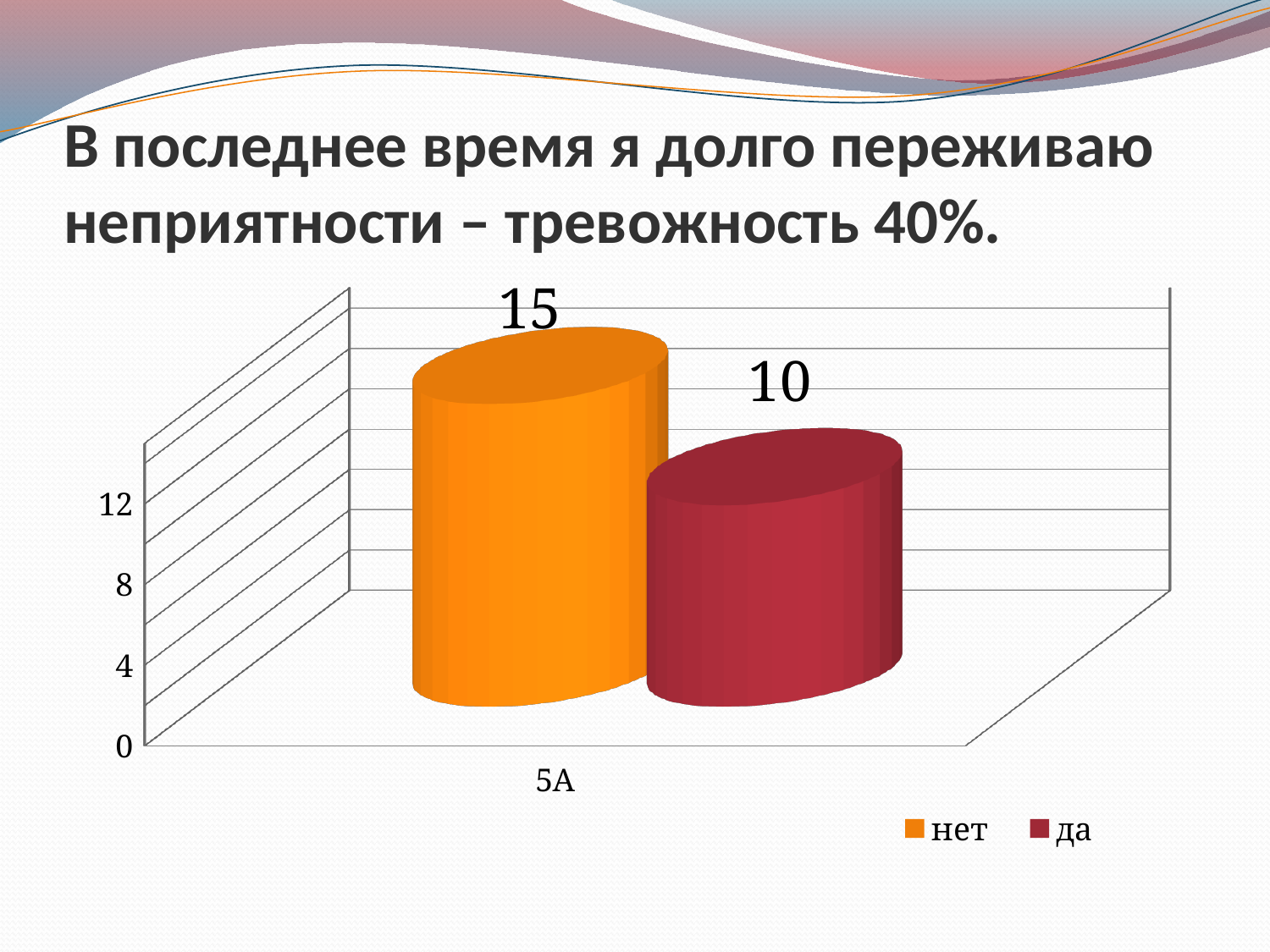
Which series has the higher value: "нет" or "да"? нет How many categories are shown on the x axis? 1 What is the value for "да" in category 5А? 10 Is the value for "нет" greater or less than 12? greater What is the value for "нет" in category 5А? 15 Is the value for "да" greater or less than 12? less What is the difference between the values for "нет" and "да"? 5 What is the label of the category on the x axis? 5А Which series has the lowest value? да How many series does the legend list? 2 What kind of chart is shown on the slide? bar chart Which colour represents the series "да" in the legend? dark red